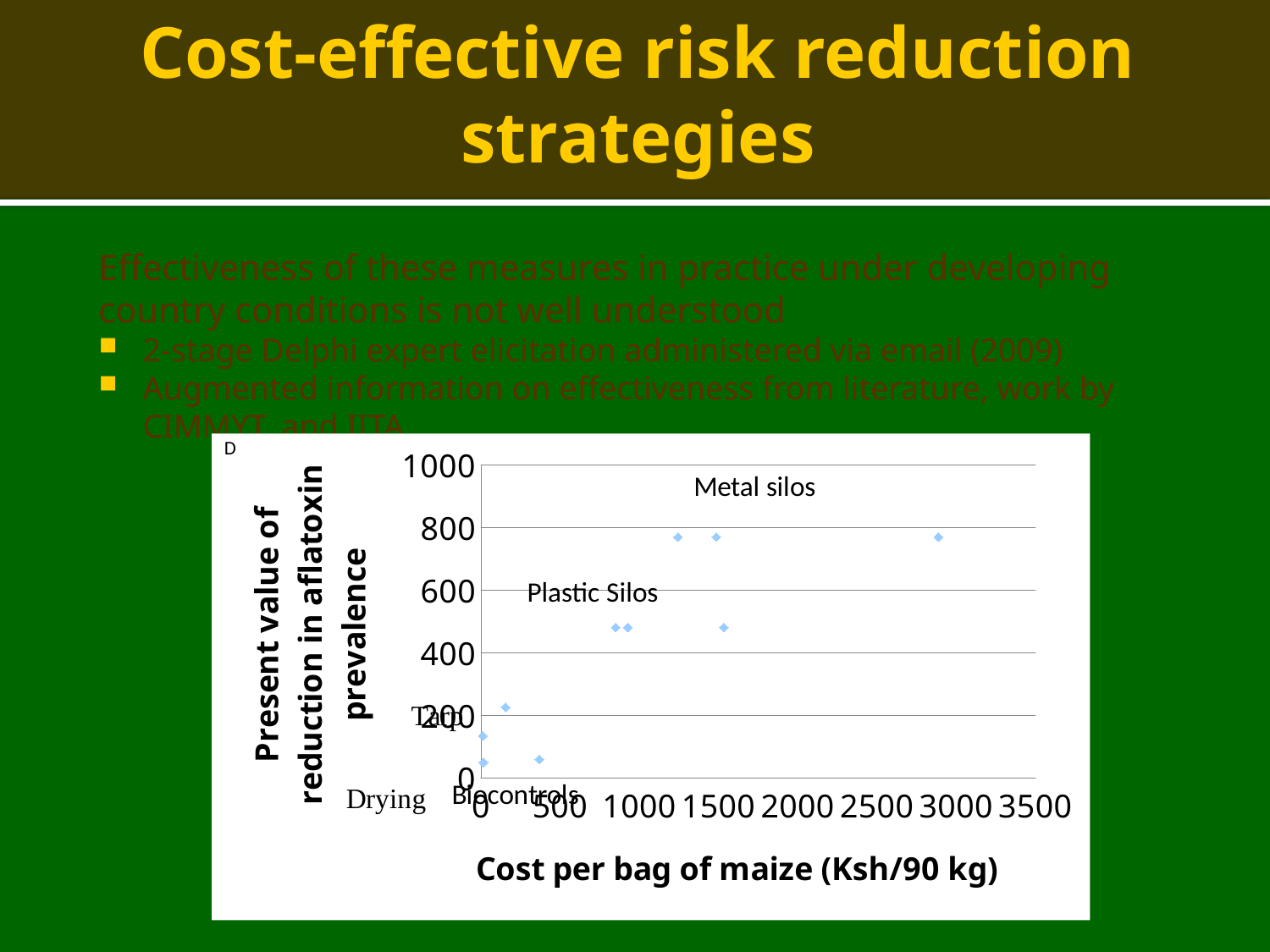
What kind of chart is shown on the slide? scatter chart What is the title of the y axis of the chart? Present value of reduction in aflatoxin prevalence Is the present value of reduction for the Metal silos points greater or less than 600? greater Is the present value of reduction for the Plastic Silos points greater or less than 400? greater Is the present value of reduction for the Plastic Silos points greater or less than 600? less Which has a higher present value of reduction in aflatoxin prevalence, Metal silos or Plastic Silos? Metal silos Which labelled strategy has the lowest cost per bag of maize? Drying What is the title of the x axis of the chart? Cost per bag of maize (Ksh/90 kg) Do the present values of reduction generally rise or fall as the cost per bag of maize increases? rise Which labelled strategy has the highest present value of reduction in aflatoxin prevalence? Metal silos